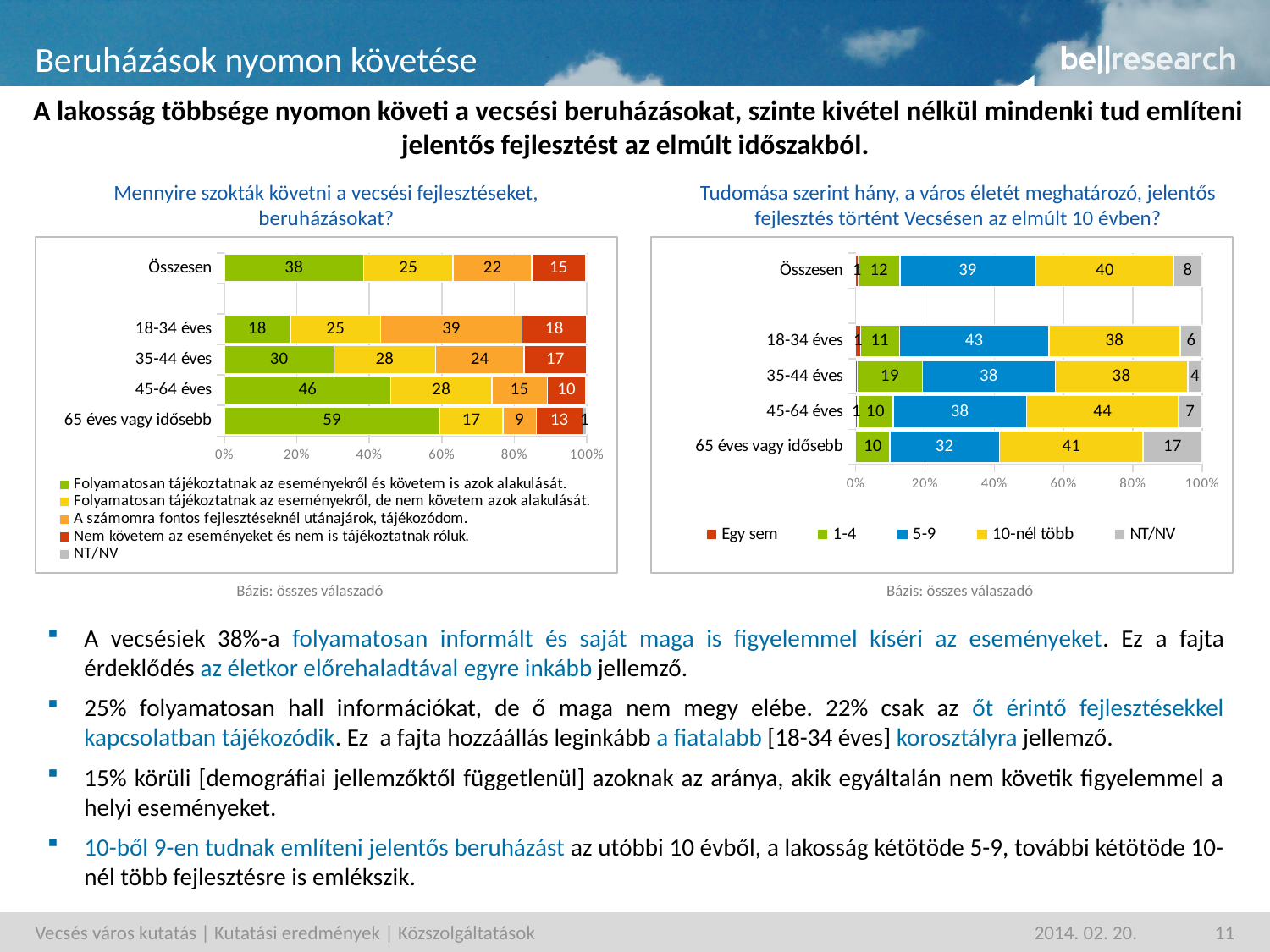
In the right chart, is the 5-9 value larger for 18-34 éves or for 65 éves vagy idősebb? 18-34 éves How many age categories (including Összesen) are plotted in the right chart? 5 In the right chart, which age group has the highest value for the 10-nél több segment? 45-64 éves In the right chart, which age group has the highest value for the NT/NV segment? 65 éves vagy idősebb In the left chart, which age group has the lowest value for the green segment (Folyamatosan tájékoztatnak az eseményekről és követem is azok alakulását)? 18-34 éves In the left chart, how many series does the legend list? 5 In the left chart, what is the value of the red segment (Nem követem az eseményeket és nem is tájékoztatnak róluk) for Összesen? 15 In the left chart (Mennyire szokták követni a vecsési fejlesztéseket, beruházásokat?), what is the value of the green segment (Folyamatosan tájékoztatnak az eseményekről és követem is azok alakulását) for 65 éves vagy idősebb? 59 In the left chart, which age group has the highest value for the green segment (Folyamatosan tájékoztatnak az eseményekről és követem is azok alakulását)? 65 éves vagy idősebb What type of chart is the left chart? Stacked bar chart In the right chart (Tudomása szerint hány, a város életét meghatározó, jelentős fejlesztés történt Vecsésen az elmúlt 10 évben?), what is the value of the 5-9 segment for Összesen? 39 In the left chart, what is the difference between the orange segment (A számomra fontos fejlesztéseknél utánajárok, tájékozódom) for 18-34 éves and for 65 éves vagy idősebb? 30